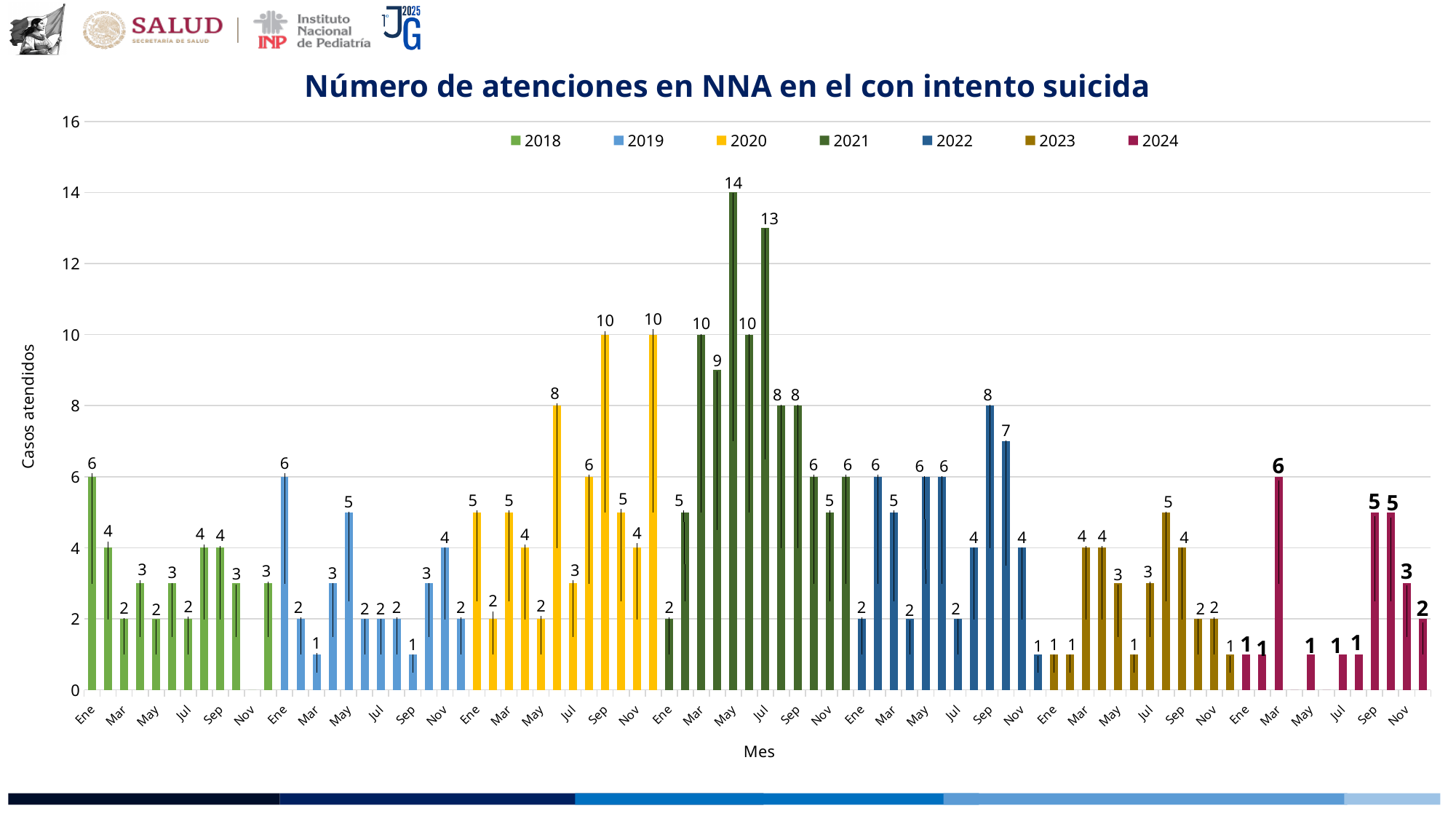
What is the title of the chart? Número de atenciones en NNA en el con intento suicida Which month of 2022 has the highest value? Sep What type of chart is shown on the slide? bar chart What is the value for May 2021? 14 Do the values for 2021 rise or fall from Jul to Nov? fall How many series (years) does the legend list? 7 What is the value for Jul 2021? 13 What is the label of the vertical axis? Casos atendidos Which is larger, the value for Sep 2022 or the value for Sep 2023? Sep 2022 What is the difference between the values for May 2021 and Jul 2021? 1 Which month of 2021 has the highest value? May What is the value for Mar 2024? 6